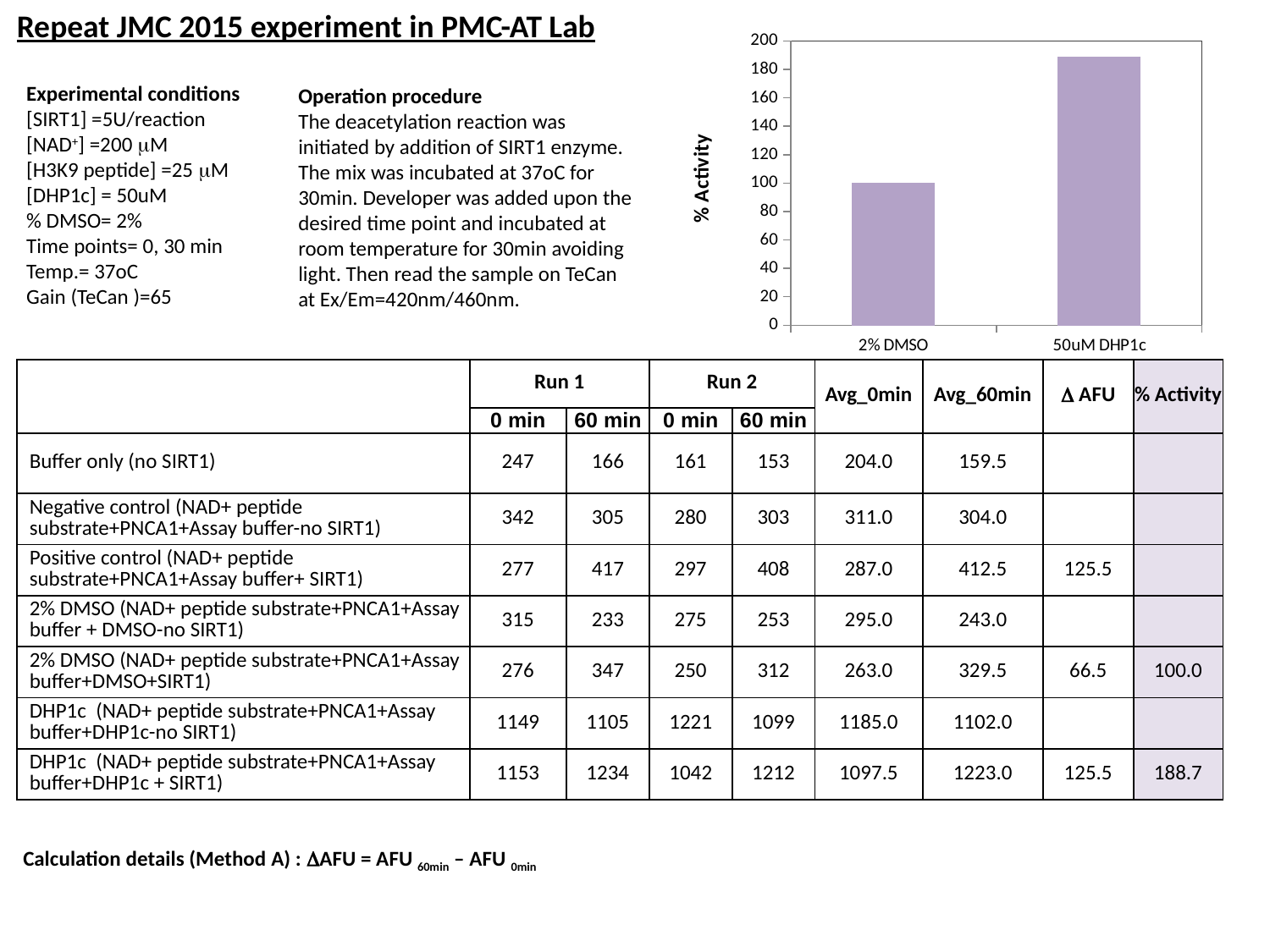
Do the bar values rise or fall from left to right along the x axis? rise Is the value for 50uM DHP1c greater or less than 180? greater What is the maximum value shown on the y axis of the chart? 200 Is the value for 2% DMSO greater or less than 120? less What kind of chart is shown on the slide? bar chart What is the % Activity value for 2% DMSO in the chart? 100 Which category has the highest bar in the chart? 50uM DHP1c How many categories are plotted on the x axis of the chart? 2 Which is larger in the chart, the value for 2% DMSO or the value for 50uM DHP1c? 50uM DHP1c Which category has the lowest bar in the chart? 2% DMSO What is the label of the y axis of the chart? % Activity Is the value for 50uM DHP1c greater or less than 200? less